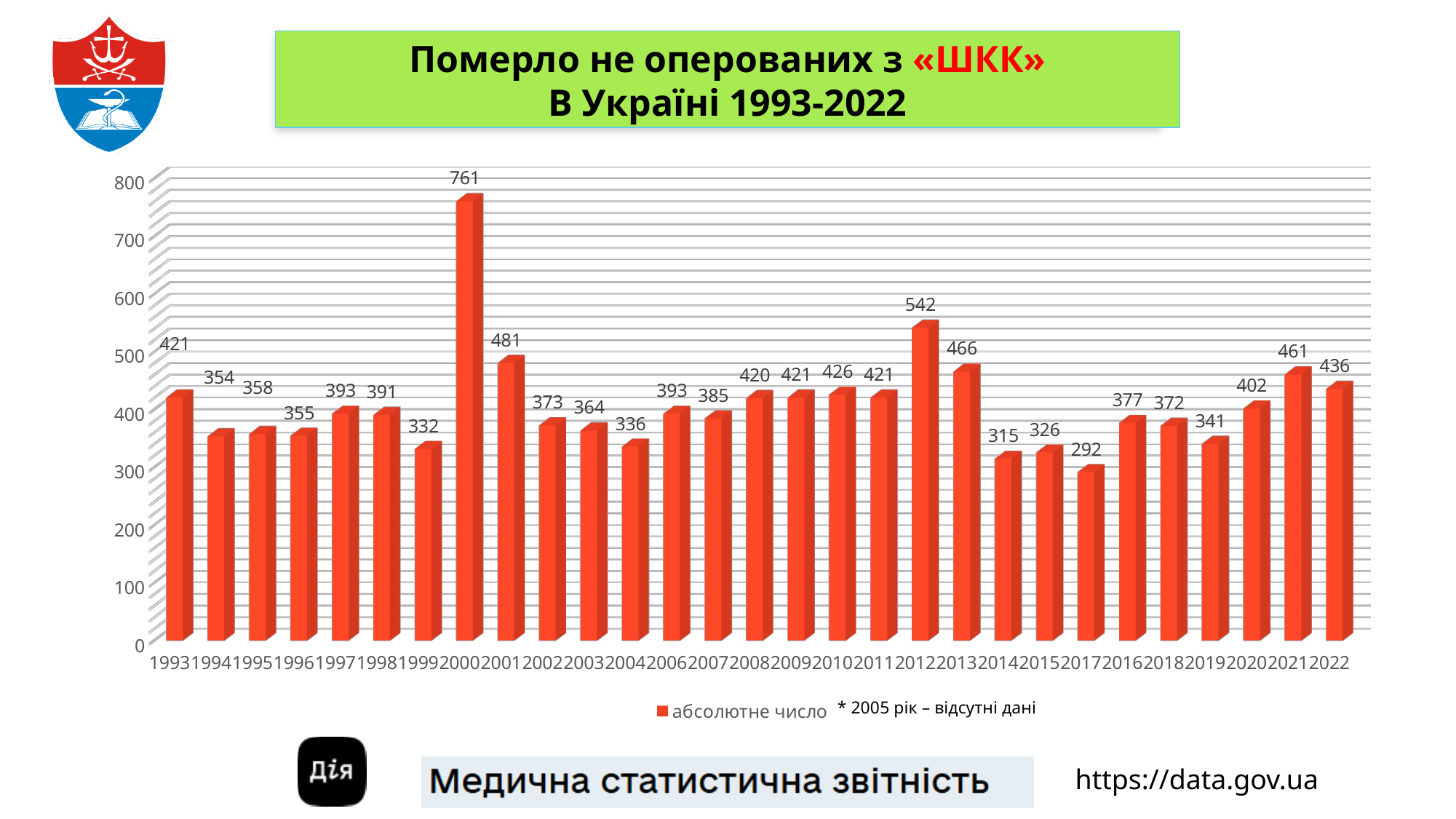
What type of chart is shown on the slide? bar chart What is the value for the year 2022? 436 Which is larger, the value for 2013 or the value for 2014? 2013 Is the value for 2017 greater or less than 300? less Which year has the highest value? 2000 What is the legend entry for the series shown? абсолютне число How many years (bars) are plotted on the chart? 29 What is the value for the year 2012? 542 Which year has the lowest value? 2017 What is the value for the year 2000? 761 What is the difference between the values for 2000 and 2001? 280 What is the difference between the values for 2021 and 2022? 25